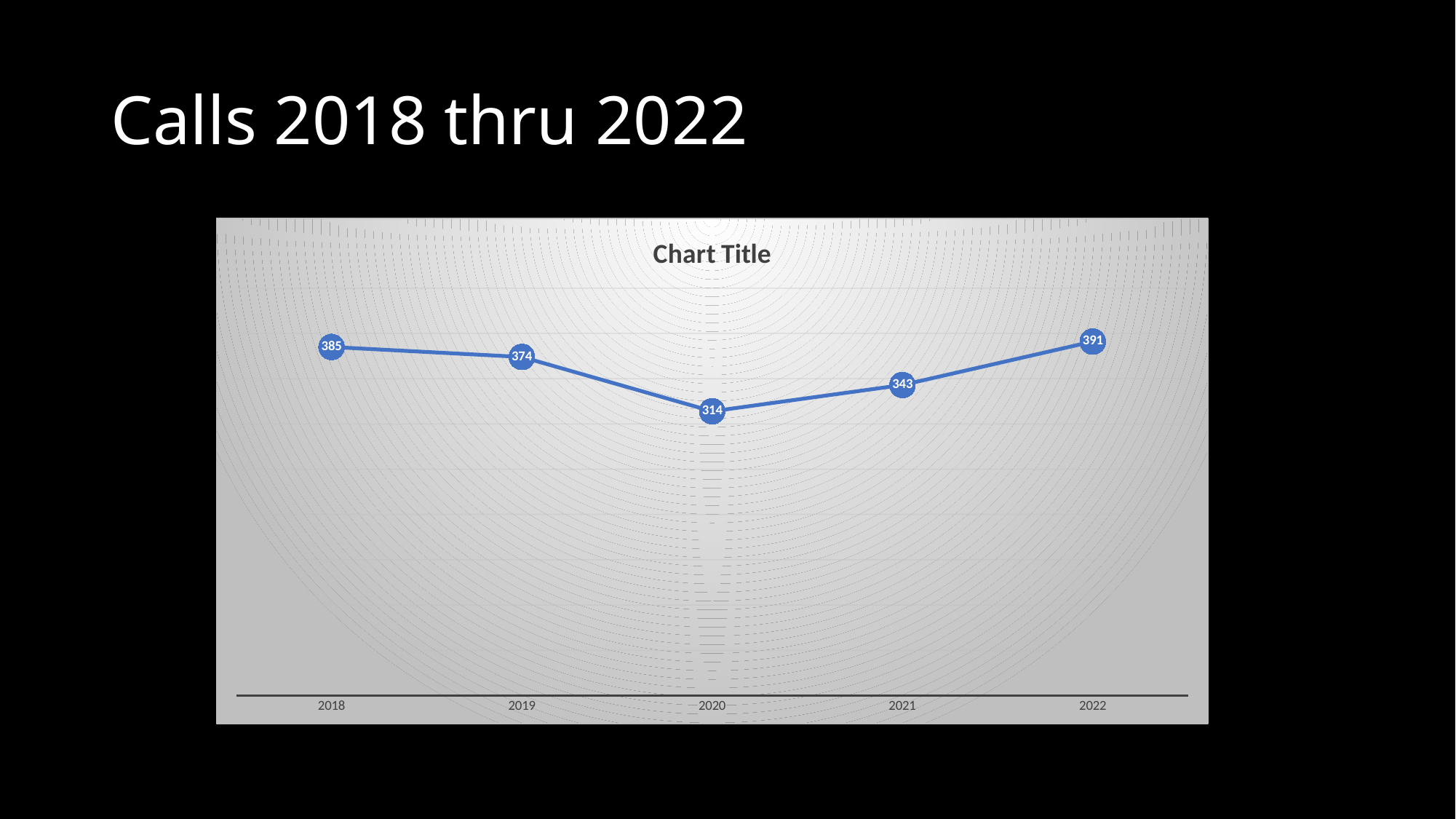
How many data points are plotted on the chart? 5 What is the value for 2022? 391 What is the difference between the values for 2022 and 2021? 48 Which is larger, the value for 2019 or the value for 2021? 2019 What is the value for 2020? 314 What is the value for 2018? 385 What is the difference between the values for 2018 and 2020? 71 What kind of chart is shown on the slide? Line chart Which year has the highest value? 2022 Which year has the lowest value? 2020 Do the values rise or fall from 2020 to 2022? Rise What is the value for 2021? 343